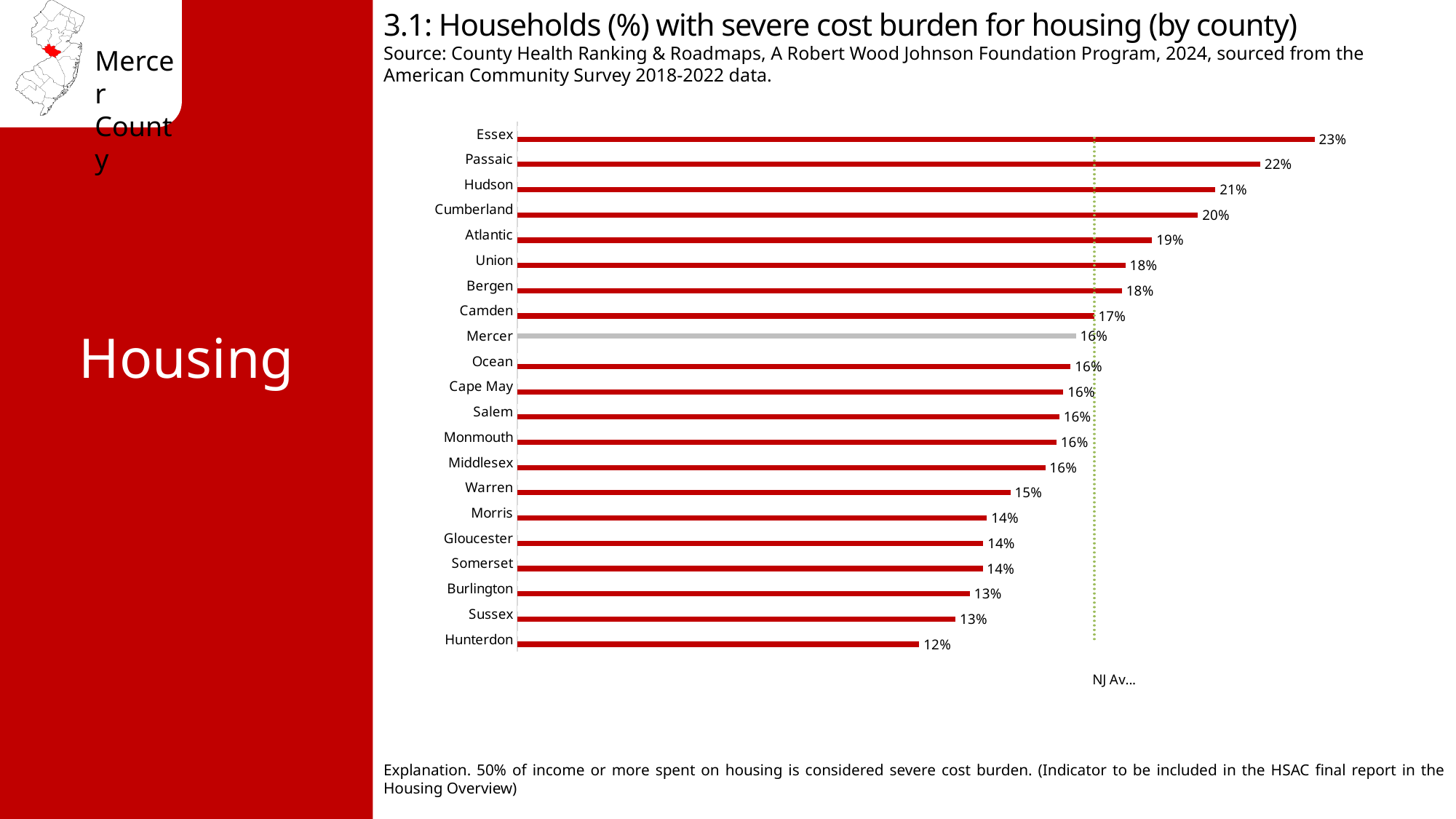
How many counties are shown in the chart? 21 What is the difference between the values for Passaic and Mercer? 6% What is the value for Mercer? 16% Which county has the lowest value? Hunterdon What is the value for Essex? 23% What is the value for Hunterdon? 12% Which county's bar is coloured grey instead of red? Mercer What kind of chart is this? Bar chart What is the value for Camden? 17% Which is larger, the value for Atlantic or the value for Warren? Atlantic What is the difference between the values for Essex and Hunterdon? 11% Which county has the highest value? Essex